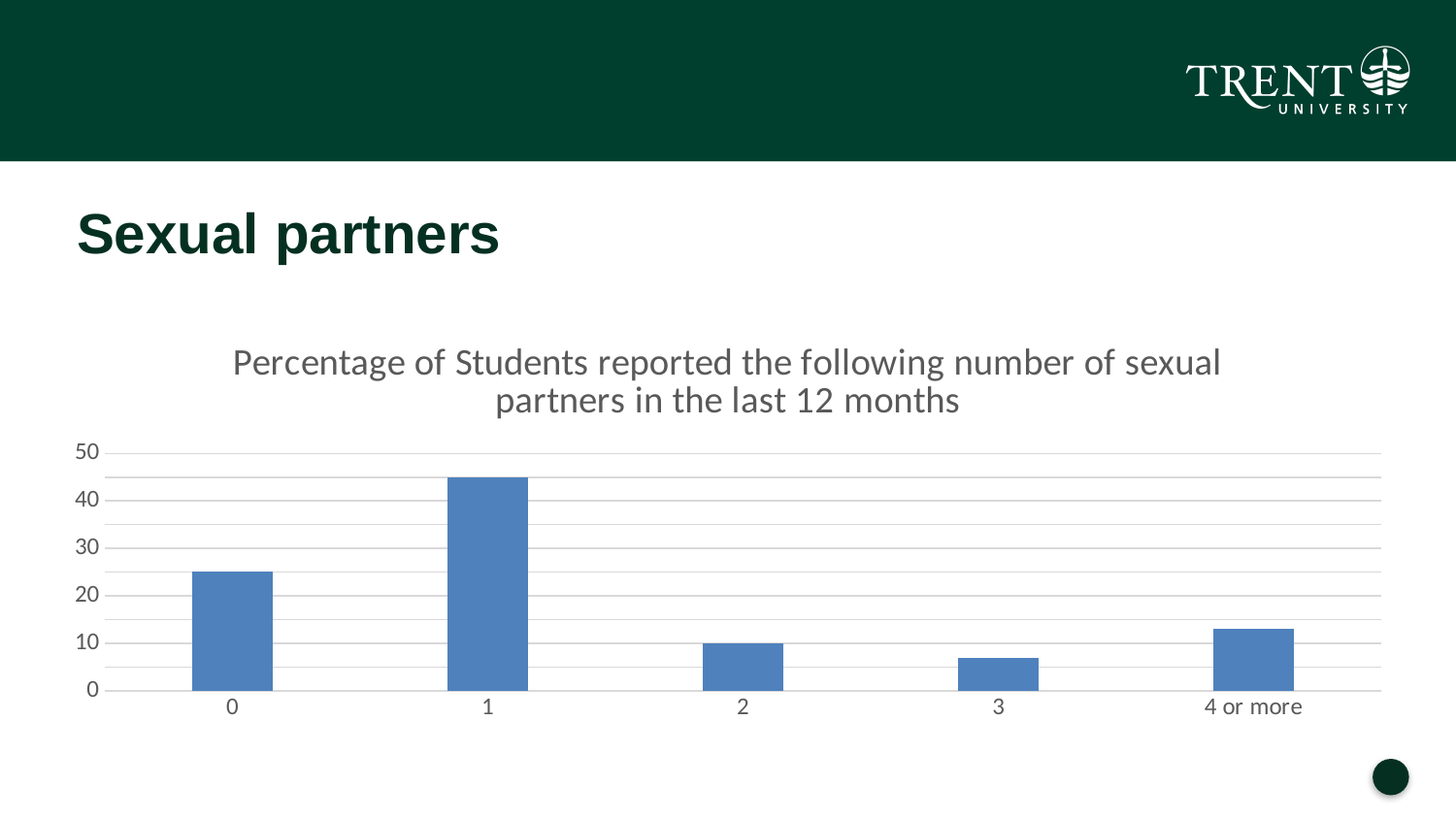
Is the value for 1 sexual partner greater or less than 40? greater Which is larger, the value for 4 or more partners or the value for 3 partners? 4 or more partners Which category has the lowest percentage of students? 3 What is the title of the chart? Percentage of Students reported the following number of sexual partners in the last 12 months What kind of chart is shown on the slide? bar chart Is the value for 4 or more sexual partners greater or less than 20? less Is the value for 3 sexual partners greater or less than 10? less Which category has the highest percentage of students? 1 How many categories are shown on the x axis of the chart? 5 What is the highest value shown on the vertical axis of the chart? 50 Which is larger, the value for 0 partners or the value for 2 partners? 0 partners